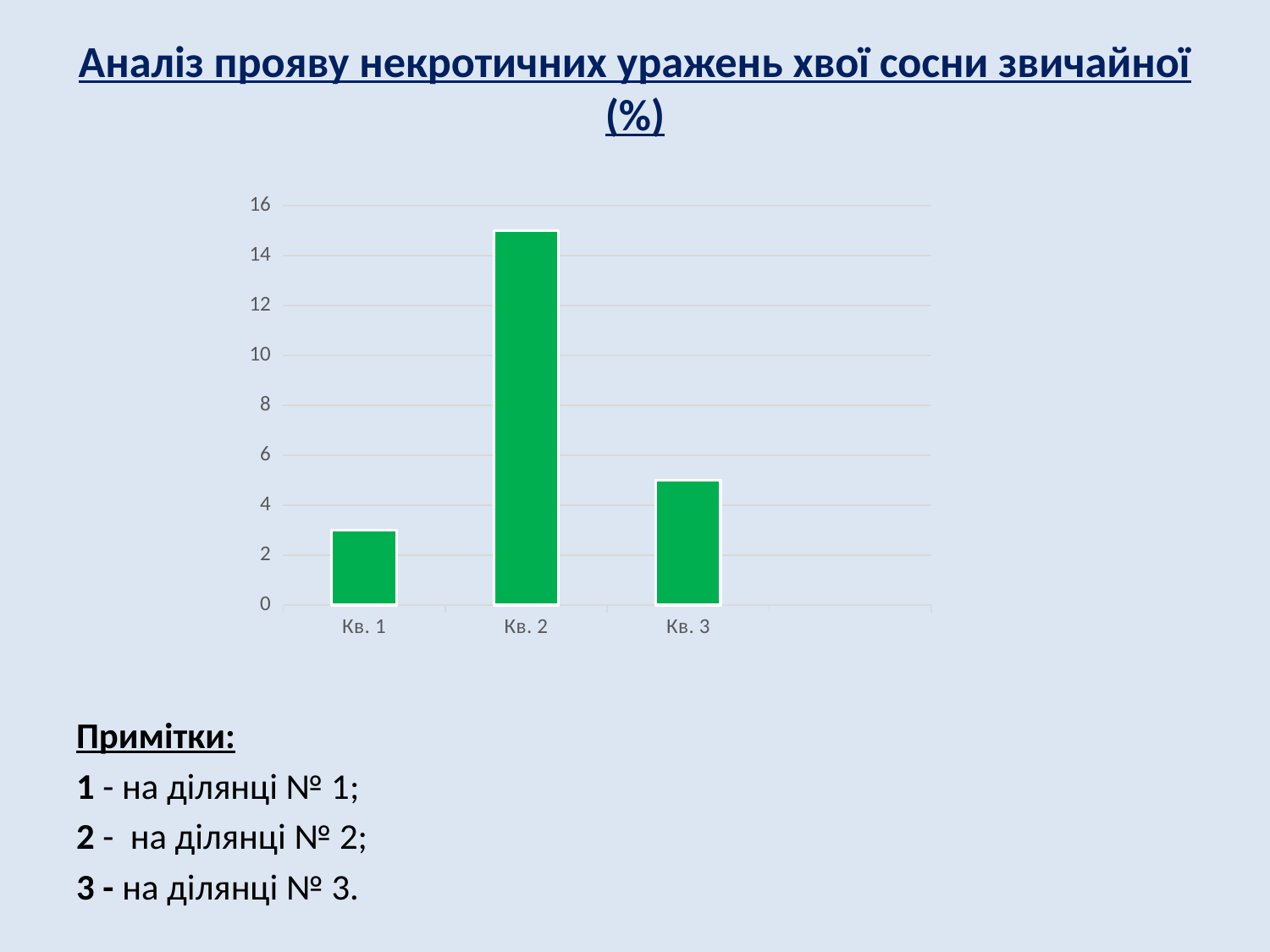
Which is larger, the value for Кв. 2 or the value for Кв. 3? Кв. 2 Which category has the highest value? Кв. 2 Which is larger, the value for Кв. 3 or the value for Кв. 1? Кв. 3 Which category has the lowest value? Кв. 1 Is the value for Кв. 1 greater or less than 4? less How many categories are plotted on the chart? 3 What kind of chart is shown on the slide? bar chart Is the value for Кв. 3 greater or less than 4? greater What is the maximum value shown on the vertical axis? 16 Is the value for Кв. 2 greater or less than 14? greater What colour are the bars in the chart? green